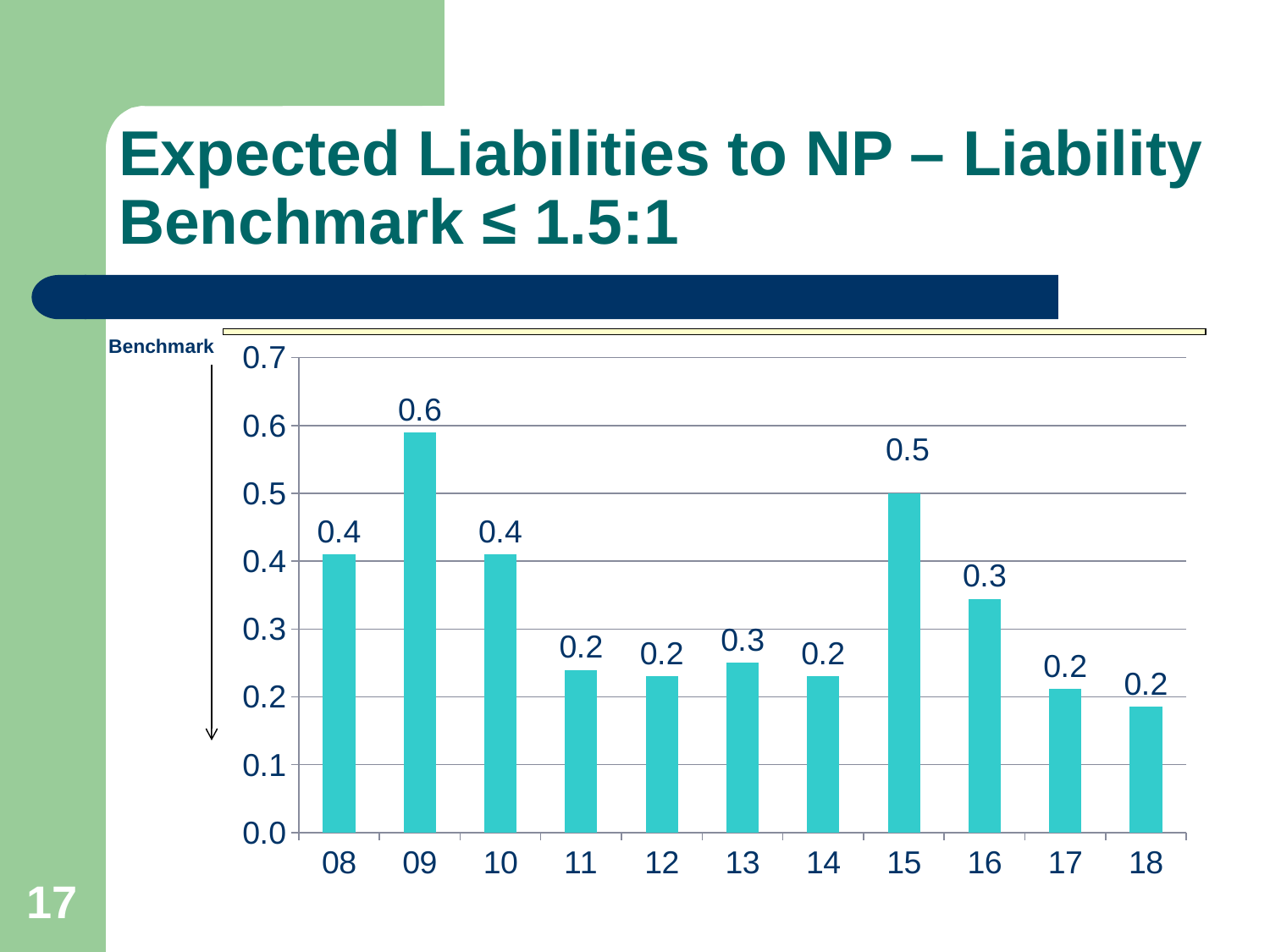
What is the value for 15? 0.5 Which year has the highest value? 09 Do the values rise or fall from 15 to 18? fall What is the value for 09? 0.6 What is the difference between the values for 09 and 08? 0.2 What is the value for 18? 0.2 Is the value for 15 greater or less than 0.4? greater Which is larger, the value for 09 or the value for 15? 09 What kind of chart is shown on the slide? bar chart How many years are shown on the x axis? 11 What is the value for 16? 0.3 Is the value for 11 greater or less than 0.3? less